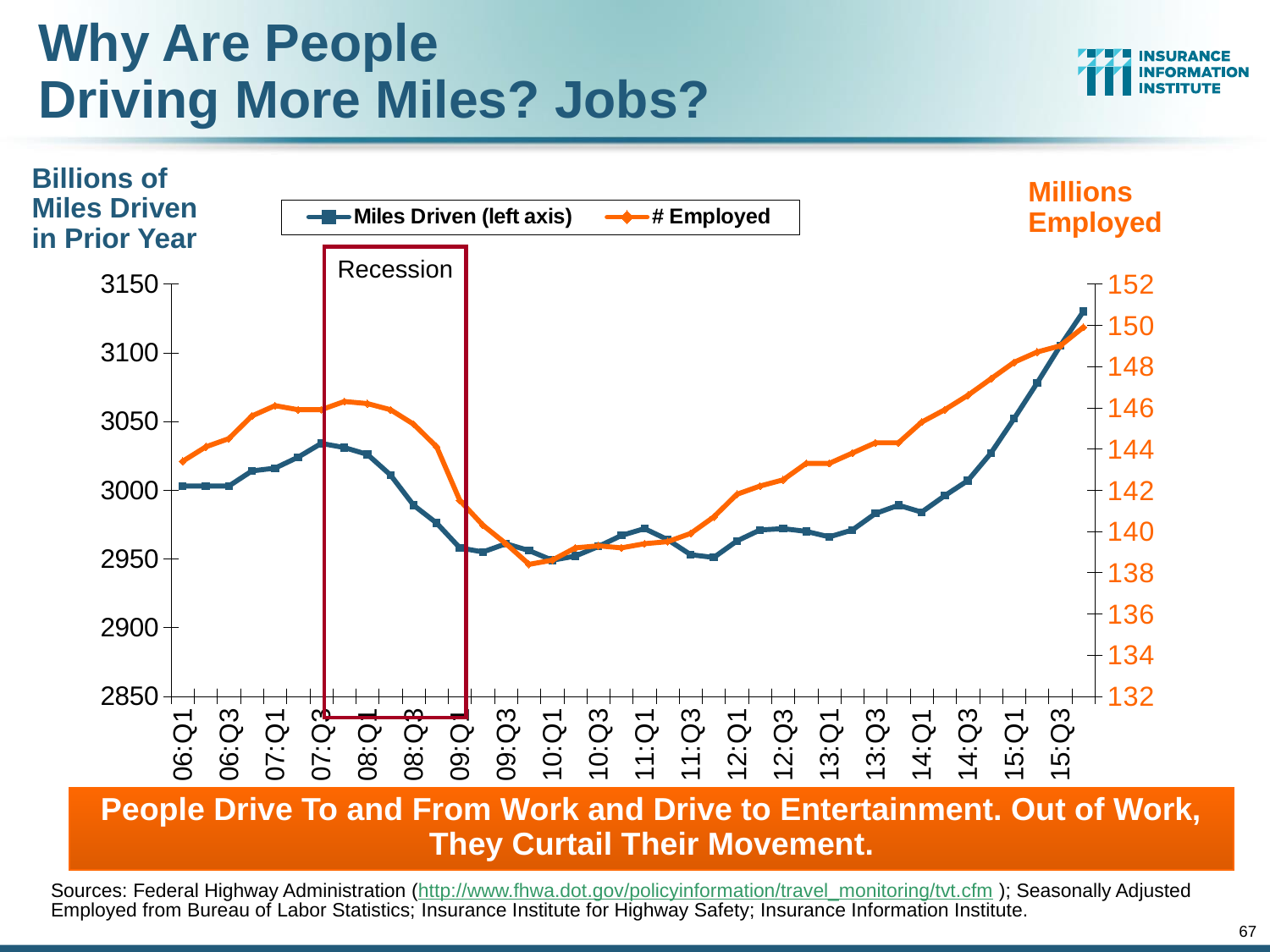
Is the value for # Employed at 09:Q3 greater or less than 140? less What label appears inside the red box drawn on the chart? Recession What kind of chart is shown on the slide? Line chart Is the value for Miles Driven at 09:Q1 greater or less than 3000? less Does the # Employed series rise or fall between 07:Q3 and 09:Q3? Fall Is the value for # Employed at 15:Q3 greater or less than 148? greater Which is larger for # Employed: the value at 09:Q3 or the value at 15:Q3? 15:Q3 Which series is plotted against the left axis according to the legend? Miles Driven How many series does the chart's legend list? 2 Does the Miles Driven series rise or fall between 13:Q1 and 15:Q3? Rise